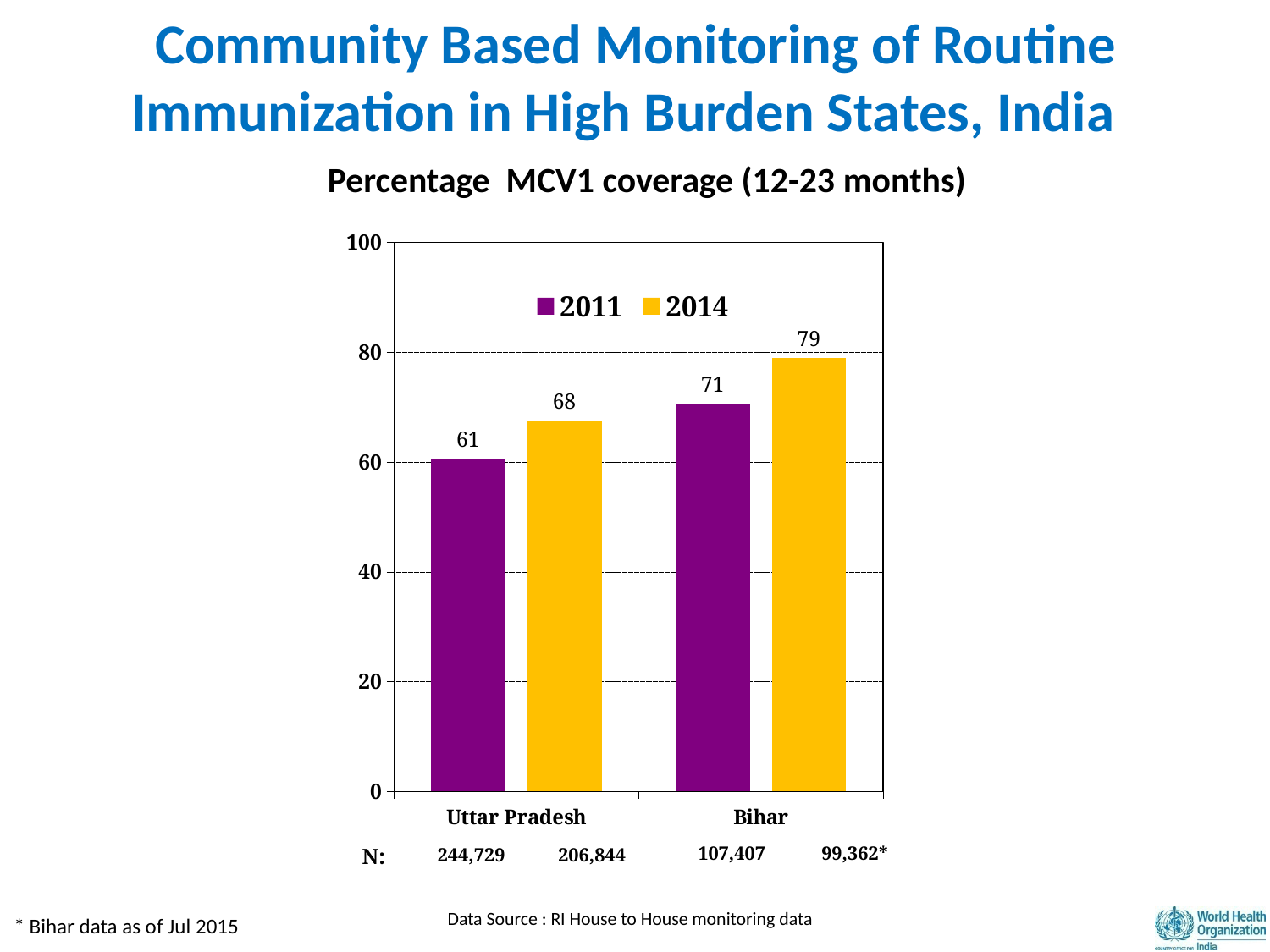
What is the difference between Bihar's and Uttar Pradesh's 2011 MCV1 coverage? 10 What is the difference between Bihar's 2014 and 2011 MCV1 coverage? 8 What kind of chart is shown on the slide? Bar chart Which bar shows the lowest value on the chart? Uttar Pradesh, 2011 Which state has the highest MCV1 coverage in 2014? Bihar What is the MCV1 coverage for Uttar Pradesh in 2011? 61 How many states are shown on the x axis? 2 How many series does the legend list? 2 Which is larger, Uttar Pradesh's 2014 coverage or Bihar's 2011 coverage? Bihar's 2011 coverage Which colour represents the 2014 series? Yellow What is the MCV1 coverage for Uttar Pradesh in 2014? 68 What is the MCV1 coverage for Bihar in 2014? 79